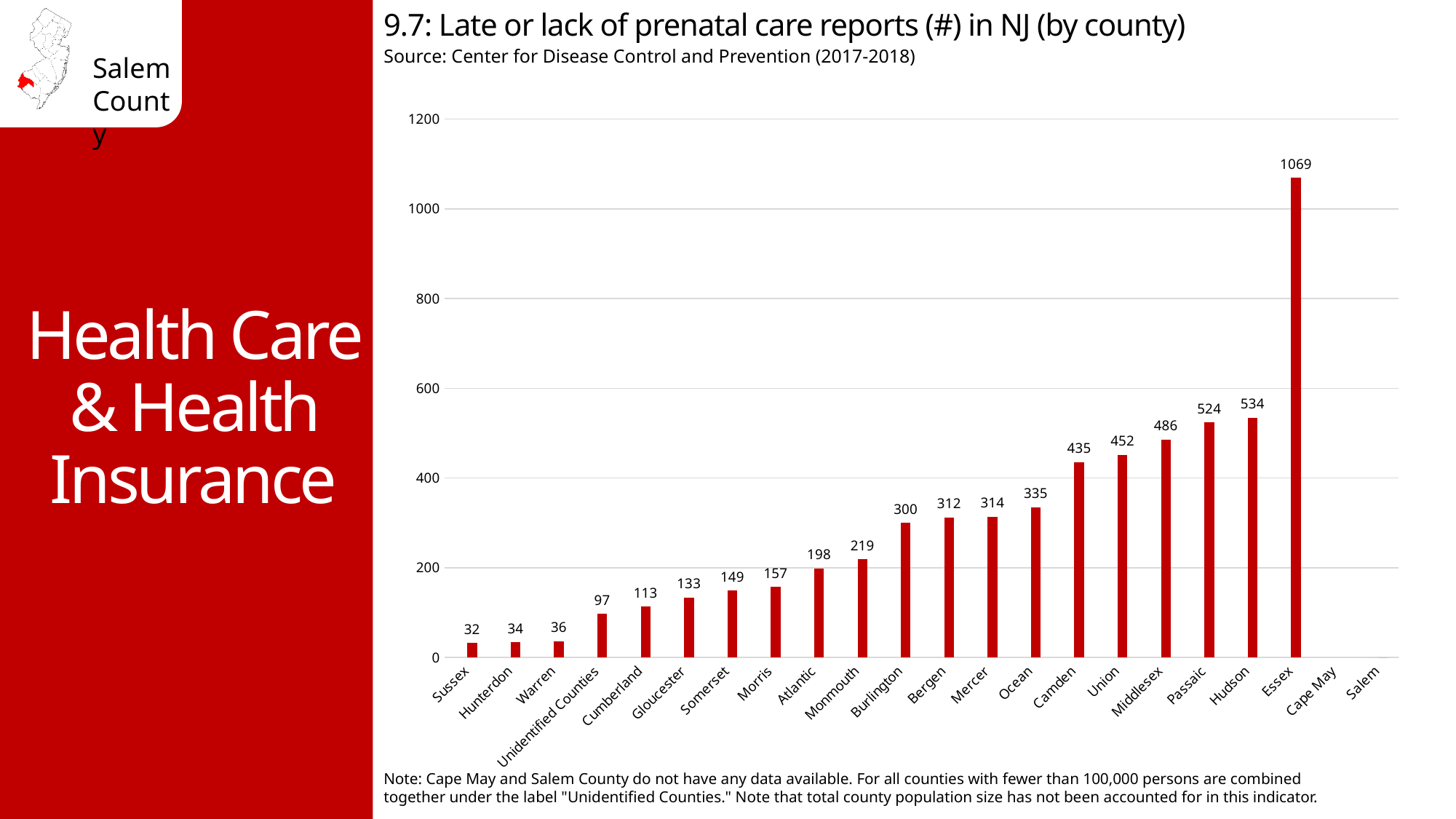
What is the difference between the values for Hudson and Passaic? 10 What is the number of late or lack of prenatal care reports for Camden? 435 Which county with a plotted bar has the lowest number of reports? Sussex Do the values generally rise or fall moving from left to right along the x axis? Rise How many counties are labeled on the x axis of the chart? 22 What is the difference between the values for Essex and Hudson? 535 Which has more reports, Monmouth or Burlington? Burlington Which county has the highest number of late or lack of prenatal care reports? Essex What is the value shown for Unidentified Counties? 97 What type of chart is shown on the slide? Bar chart Is the value for Middlesex greater or less than 400? greater What is the number of late or lack of prenatal care reports for Essex? 1069